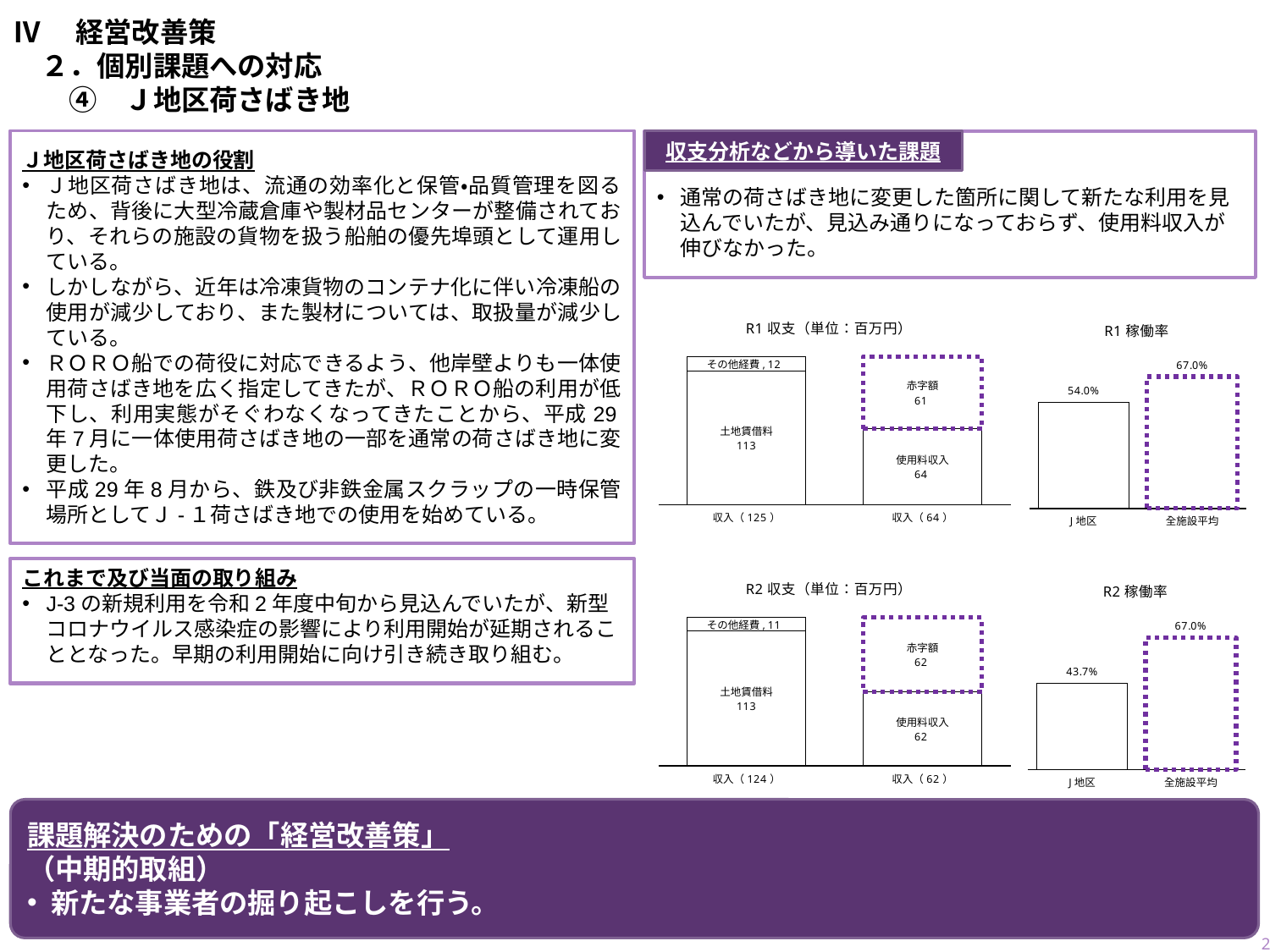
In the R2 収支 chart, what is the value of その他経費? 11 In the R2 収支 chart, what is the 赤字額? 62 In the R2 稼働率 chart, what is the value for J地区? 43.7% In the R1 稼働率 chart, what is the difference between 全施設平均 and J地区? 13.0% In the R2 稼働率 chart, which is higher, J地区 or 全施設平均? 全施設平均 In the R1 収支 chart, what is the value of 土地賃借料? 113 In the R1 収支 chart, what is the total of the left stacked bar (土地賃借料 plus その他経費)? 125 In the R1 収支 chart, what is the 赤字額? 61 What kind of chart is the R2 稼働率 chart? bar chart In the R1 収支 chart, what is the 使用料収入? 64 In the R1 収支 chart, what is the value of その他経費? 12 In the R1 稼働率 chart, what is the value for J地区? 54.0%